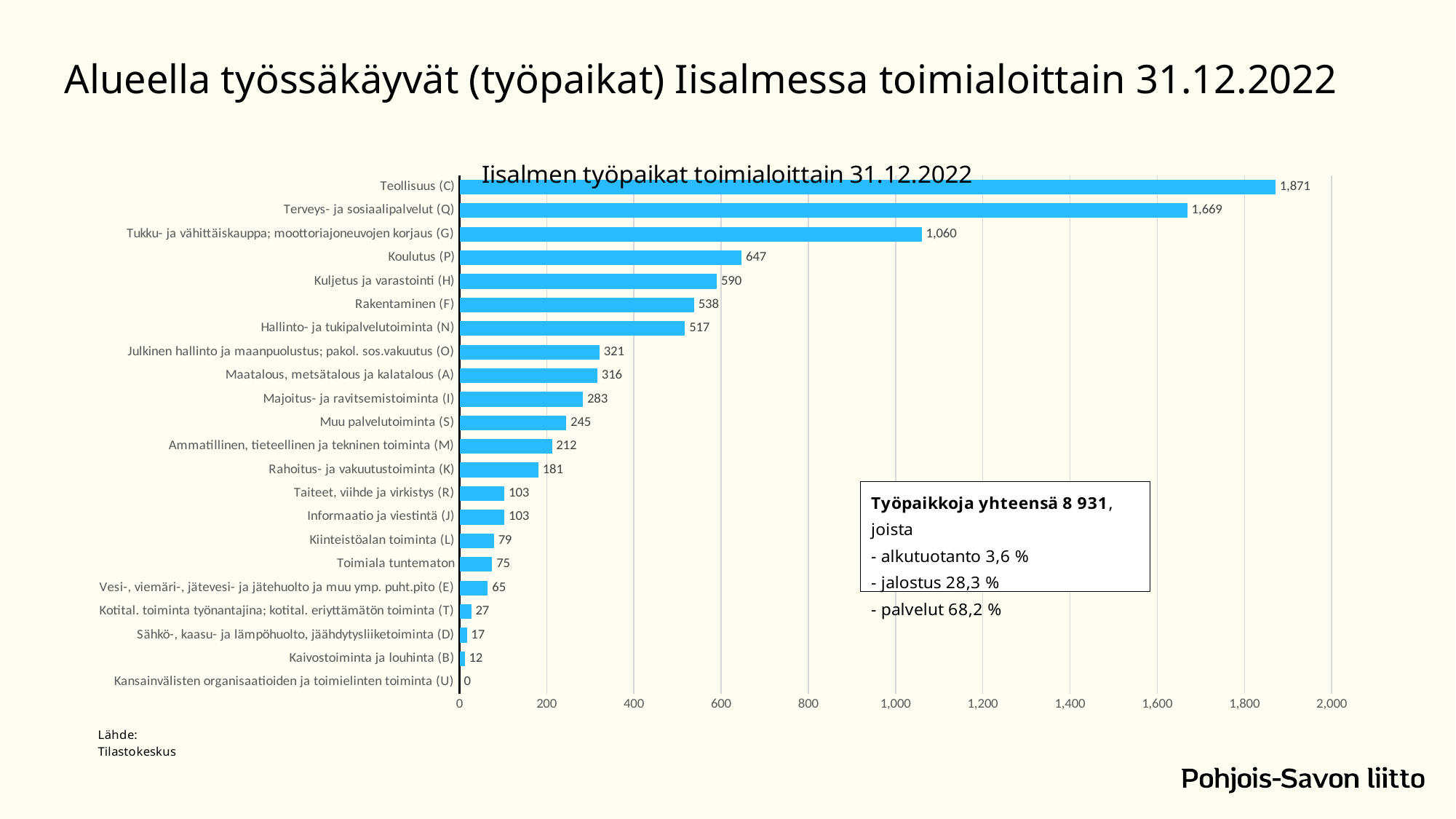
What is the value for Rahoitus- ja vakuutustoiminta (K)? 181 Which category has the highest value? Teollisuus (C) What is the difference between Kuljetus ja varastointi (H) and Rakentaminen (F)? 52 What is the value for Teollisuus (C)? 1,871 How many categories are shown in the chart? 22 What is the difference between Teollisuus (C) and Terveys- ja sosiaalipalvelut (Q)? 202 What is the title of the chart? Iisalmen työpaikat toimialoittain 31.12.2022 Is the value for Tukku- ja vähittäiskauppa; moottoriajoneuvojen korjaus (G) greater or less than 1,000? greater What is the value for Koulutus (P)? 647 Which category has the lowest value? Kansainvälisten organisaatioiden ja toimielinten toiminta (U) What kind of chart is shown on the slide? bar chart Which is larger, Rakentaminen (F) or Hallinto- ja tukipalvelutoiminta (N)? Rakentaminen (F)